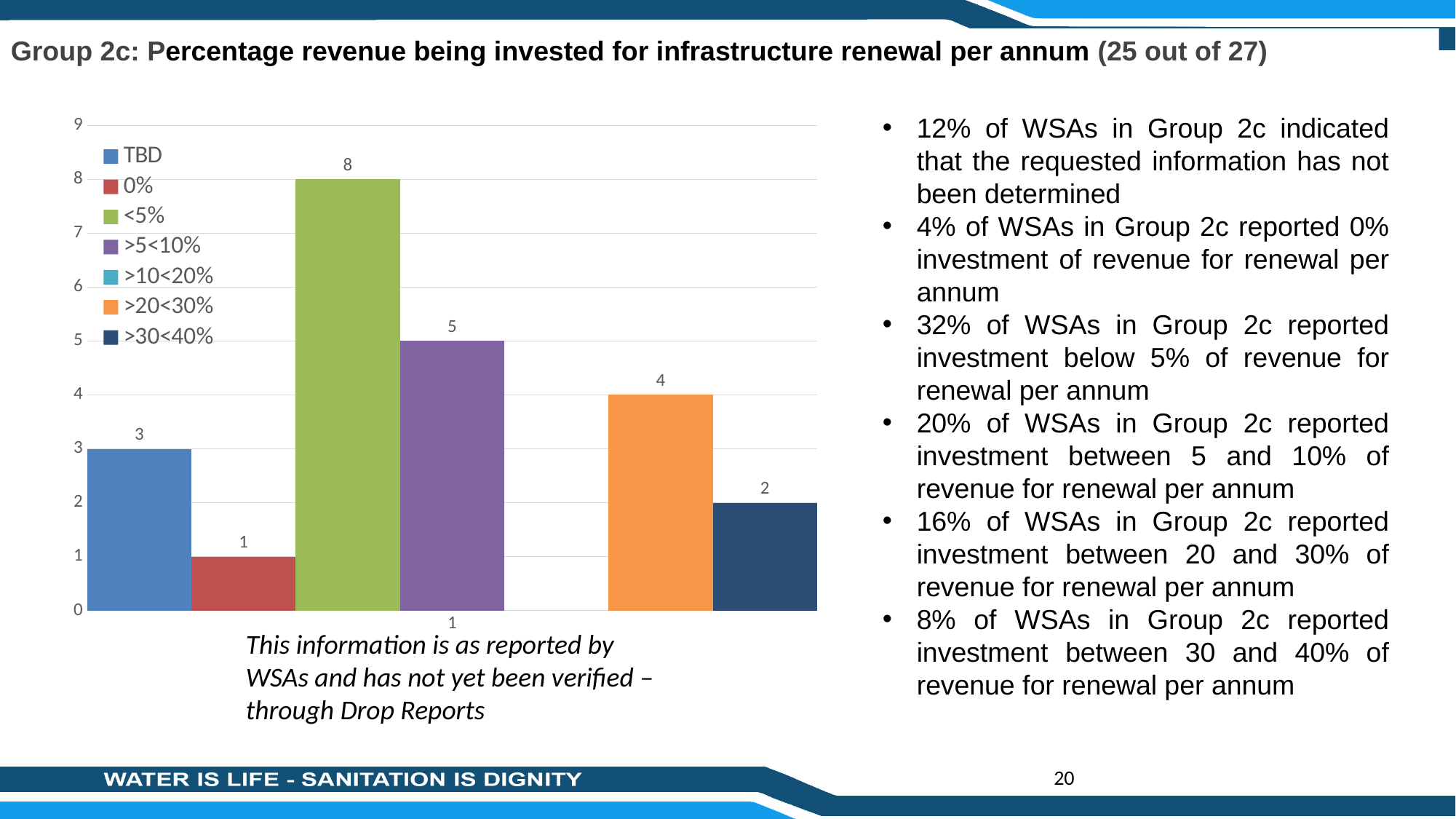
What is the difference between the <5% value and the >5<10% value? 3 What kind of chart is shown on the slide? Bar chart What value is shown for the >5<10% series? 5 What value is shown for the 0% series? 1 What is the maximum value shown on the vertical axis? 9 What value is shown for the TBD series? 3 Which is larger, the value for TBD or the value for >20<30%? >20<30% What value is shown for the >30<40% series? 2 Which series has the highest value? <5% What value is shown for the >20<30% series? 4 How many series does the legend list? 7 What value is shown for the <5% series? 8